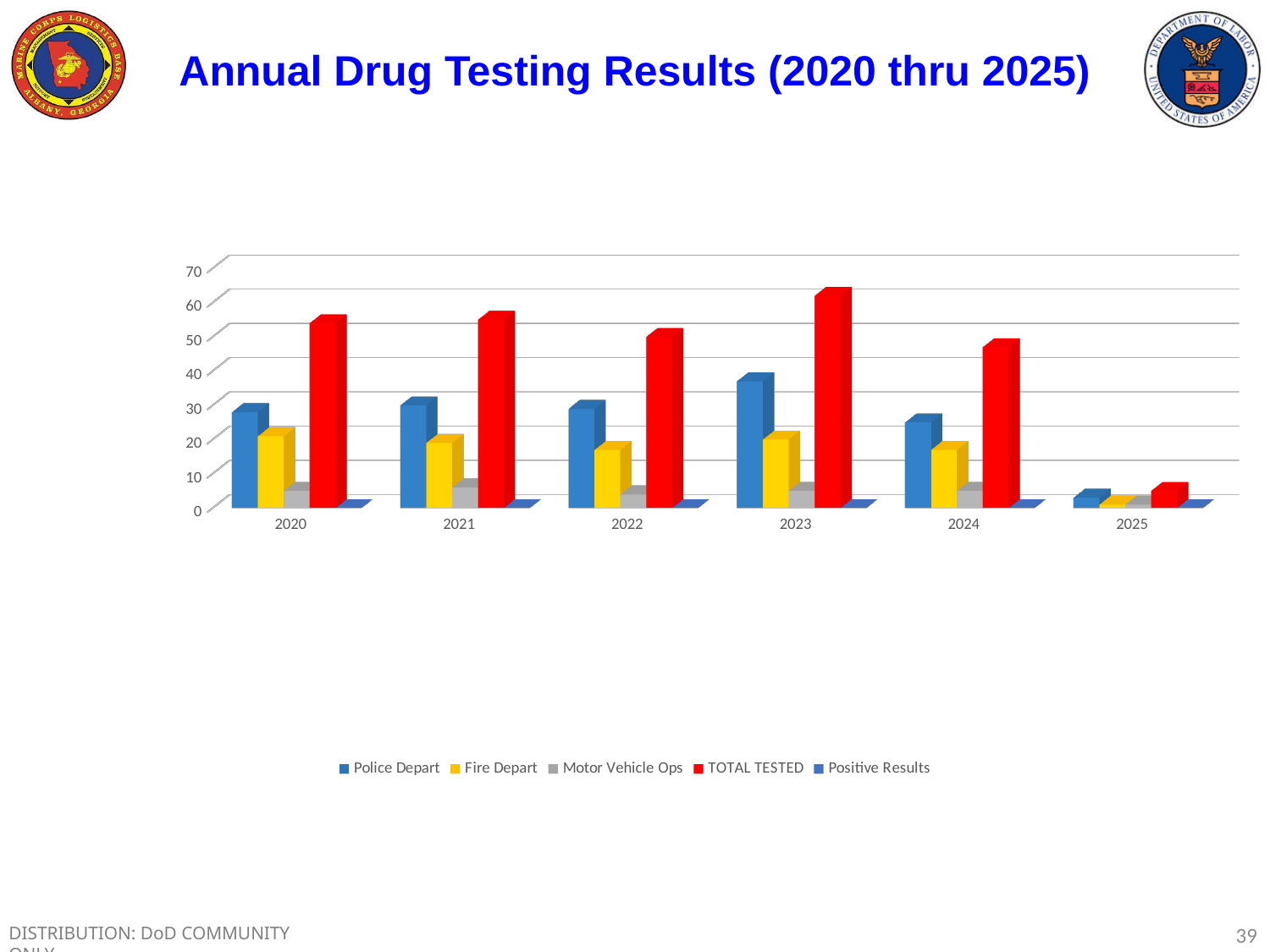
How many series does the chart's legend list? 5 Is the TOTAL TESTED value for 2025 greater or less than 10? less Is the TOTAL TESTED value for 2023 greater or less than 60? greater Do the TOTAL TESTED values rise or fall from 2023 to 2025? fall In which year is the TOTAL TESTED bar the highest? 2023 Which is larger in 2023, the Police Depart value or the Fire Depart value? Police Depart How many years are shown along the x axis of the chart? 6 Which is larger, the TOTAL TESTED value for 2023 or for 2024? 2023 Which series is shown in red in the chart? TOTAL TESTED Is the Police Depart value for 2024 greater or less than 30? less What kind of chart is shown on the slide? bar chart In which year is the TOTAL TESTED bar the lowest? 2025